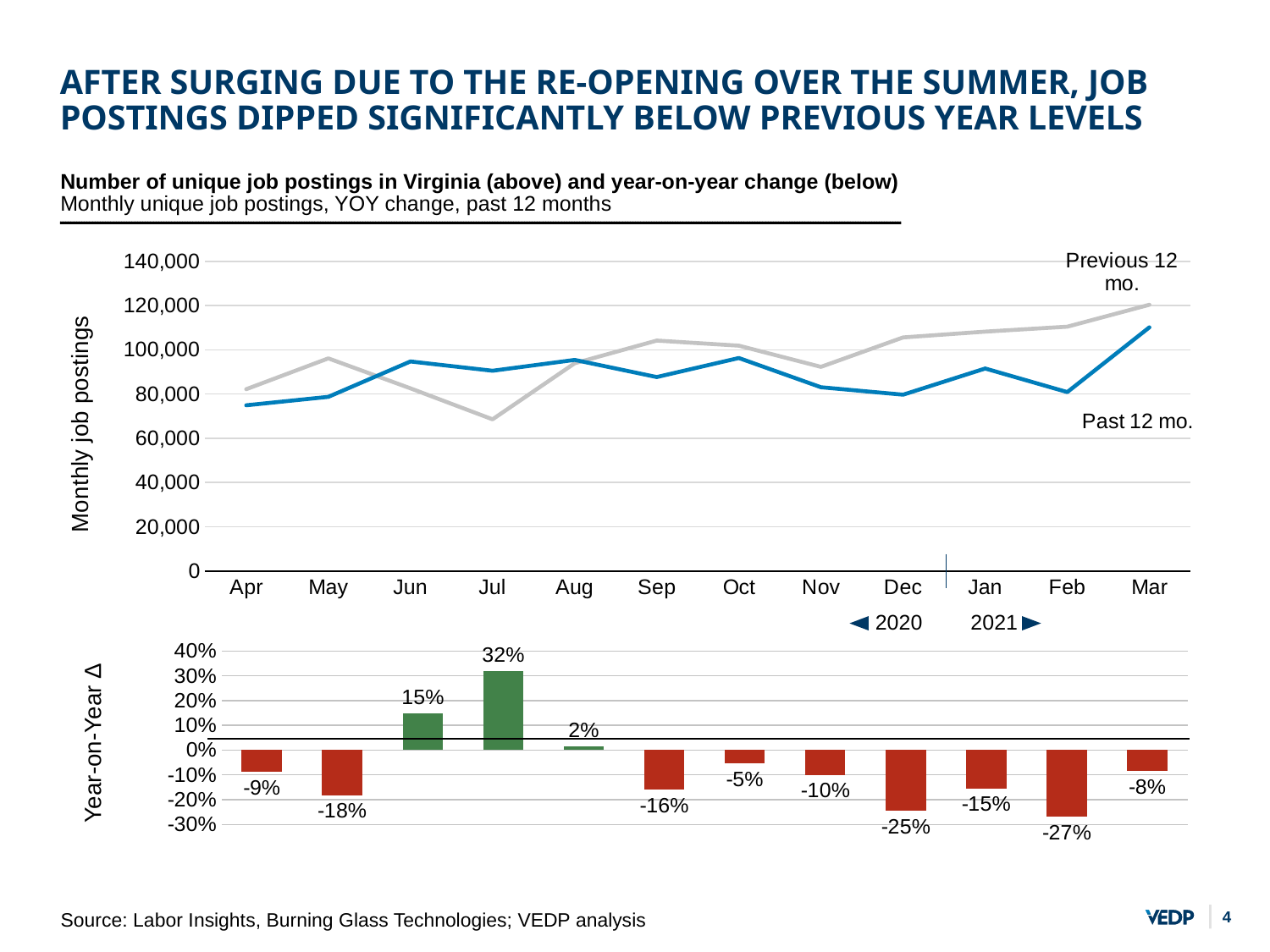
What kind of chart is the lower year-on-year change chart? Bar chart In the lower year-on-year change chart, which month has the lowest value? Feb In the lower year-on-year change chart, what is the value for Dec? -25% In the upper monthly job postings chart, how many series are plotted? 2 In the lower year-on-year change chart, which month has the highest value? Jul In the upper monthly job postings chart, is the Past 12 mo. value for Mar greater or less than 100,000? greater What kind of chart is the upper monthly job postings chart? Line chart In the lower year-on-year change chart, which is larger, the value for May or the value for Sep? Sep In the upper monthly job postings chart, is the Previous 12 mo. value for Jul greater or less than 80,000? less In the lower year-on-year change chart, what is the difference between the values for Jul and Jun? 17 percentage points In the lower year-on-year change chart, what is the value for Jul? 32% In the lower year-on-year change chart, how many months are shown? 12